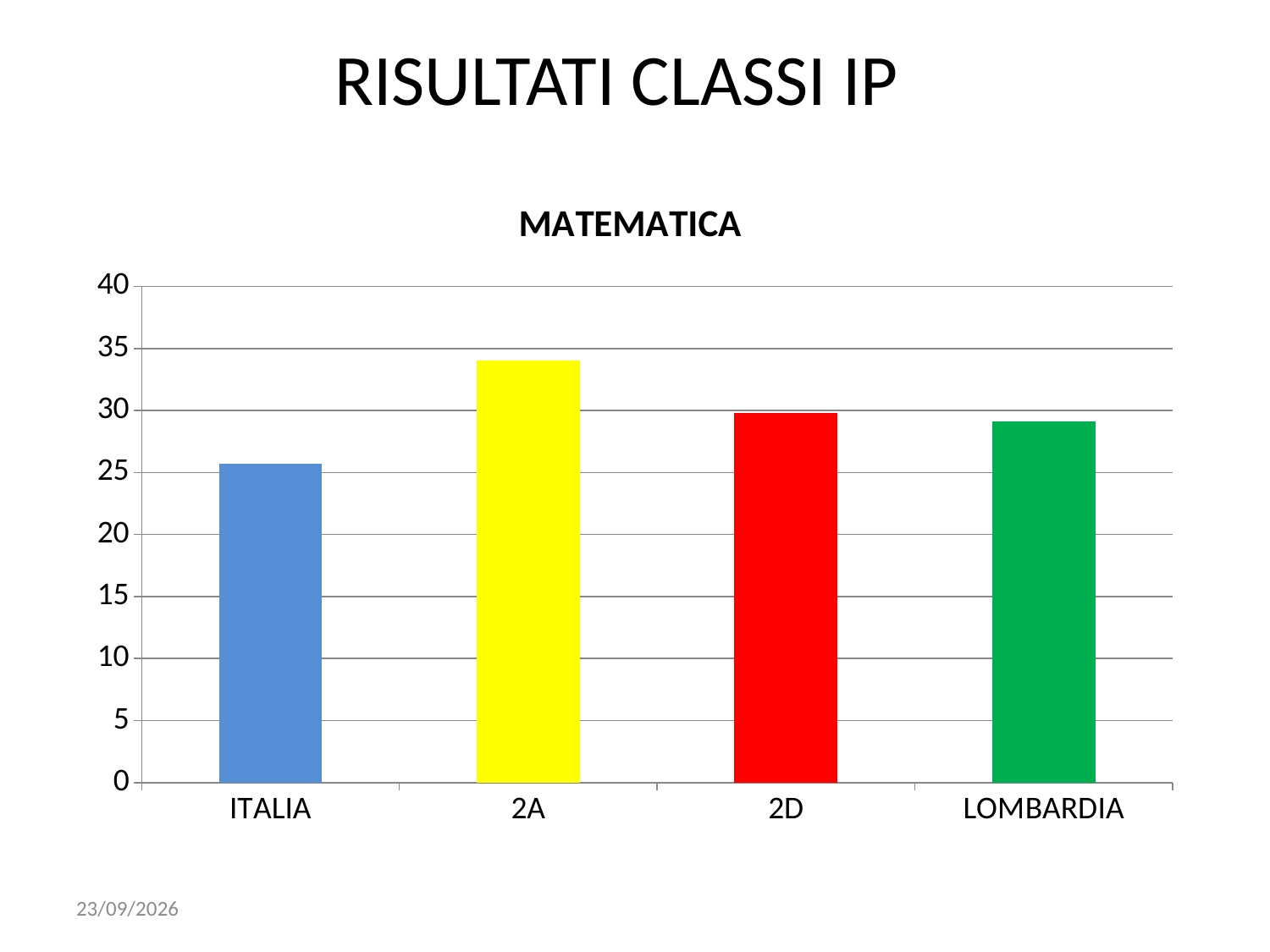
What kind of chart is shown on the slide? bar chart What is the title of the chart? MATEMATICA Which category has the lowest bar in the chart? ITALIA Is the value for 2A greater or less than 30? greater Is the value for ITALIA greater or less than 30? less Which category has the highest bar in the chart? 2A How many categories are shown on the x axis of the chart? 4 Is the value for 2A greater or less than 35? less Which is larger, the value for 2A or the value for ITALIA? 2A Which is larger, the value for LOMBARDIA or the value for ITALIA? LOMBARDIA